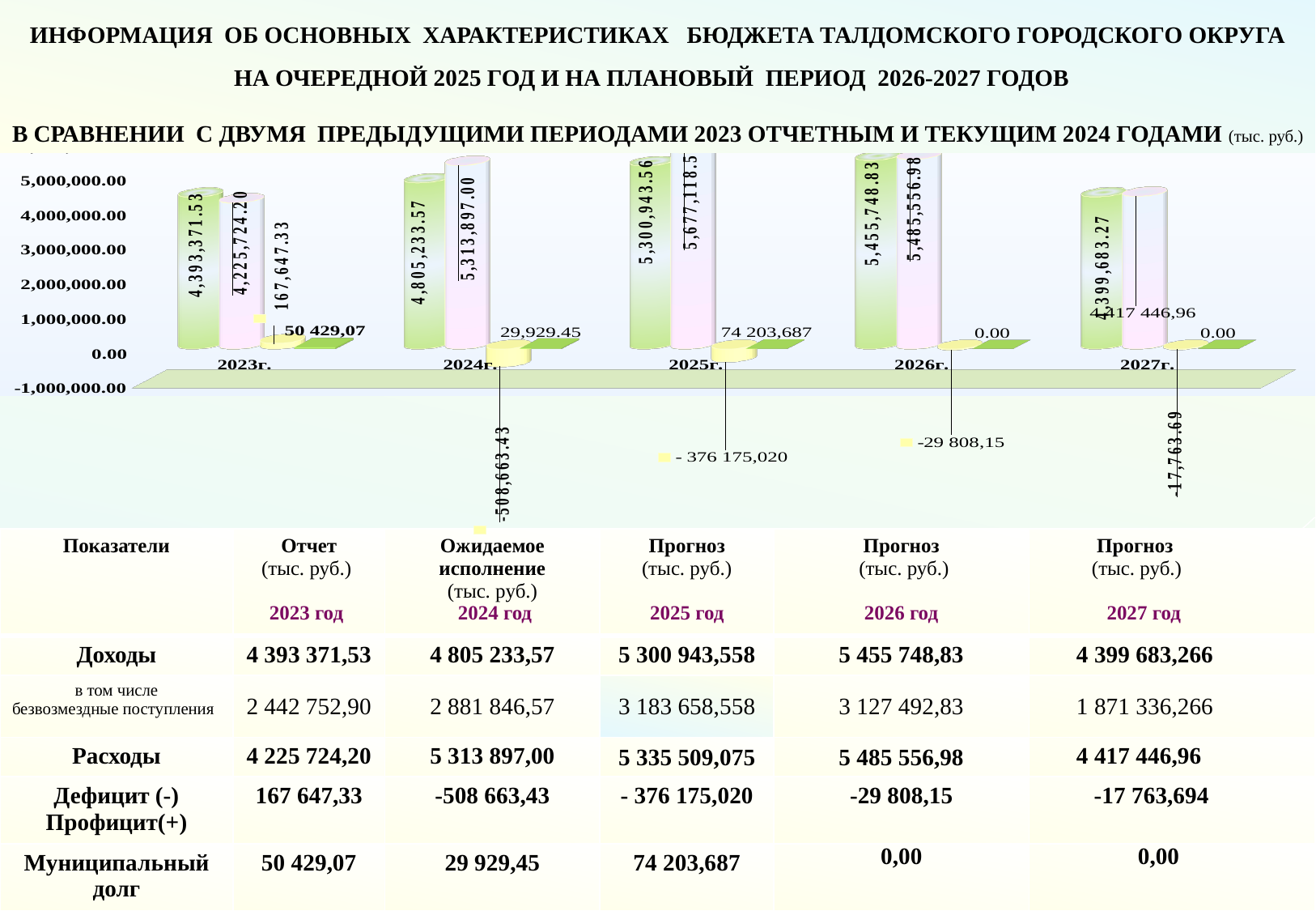
What is the value of the tallest green bar (income) for 2023г. on the chart? 4,393,371.53 What kind of chart is shown on the slide? bar chart What negative value is labelled below the axis for 2024г. on the chart? -508,663.43 For 2023г., which is larger on the chart: the green bar (4,393,371.53) or the pink bar (4,225,724.20)? the green bar (4,393,371.53) What is the difference between the green bar (4,393,371.53) and the pink bar (4,225,724.20) for 2023г.? 167,647.33 What value is labelled for municipal debt in 2026г. on the chart? 0.00 In which year is the green bar (income) lowest on the chart? 2023г. What value is labelled on the pink bar (expenses) for 2024г. on the chart? 5,313,897.00 What value is labelled for municipal debt in 2025г. on the chart? 74 203,687 Is the green bar (income) for 2027г. greater or less than 4,000,000.00? greater How many year categories are shown on the x axis of the chart? 5 In which year does the green bar (income) reach its highest value on the chart? 2026г.